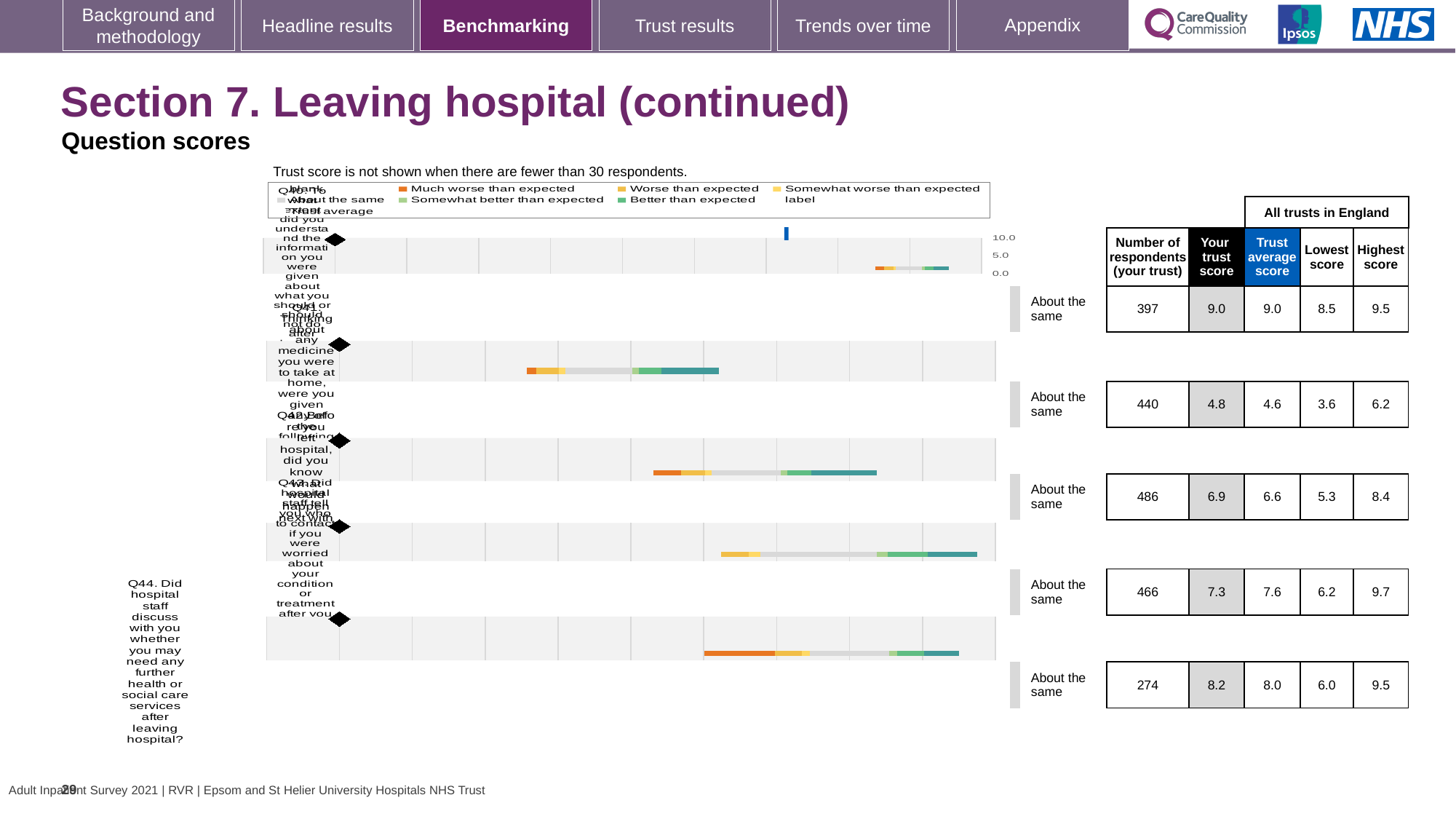
Which question row has the lowest trust score? the row with 440 respondents (4.8) What is the difference between the trust score and the trust average score for the row with 440 respondents? 0.2 Which question row has the highest trust score? the first row (9.0) For the row with 466 respondents, which is larger: the trust score or the trust average score? trust average score (7.6) What is the trust score for the question row with 440 respondents? 4.8 What is the lowest score across all trusts in England for Q44 (the last row, 274 respondents)? 6.0 What benchmark category is shown for every question row on this slide? About the same What is the trust average score for the question row with 486 respondents? 6.6 In the table, what is the number of respondents for the first question row? 397 What kind of chart is used to show the question scores? bar chart What is the highest score across all trusts in England for the question row with 466 respondents? 9.7 How many question rows are plotted in the benchmarking chart? 5